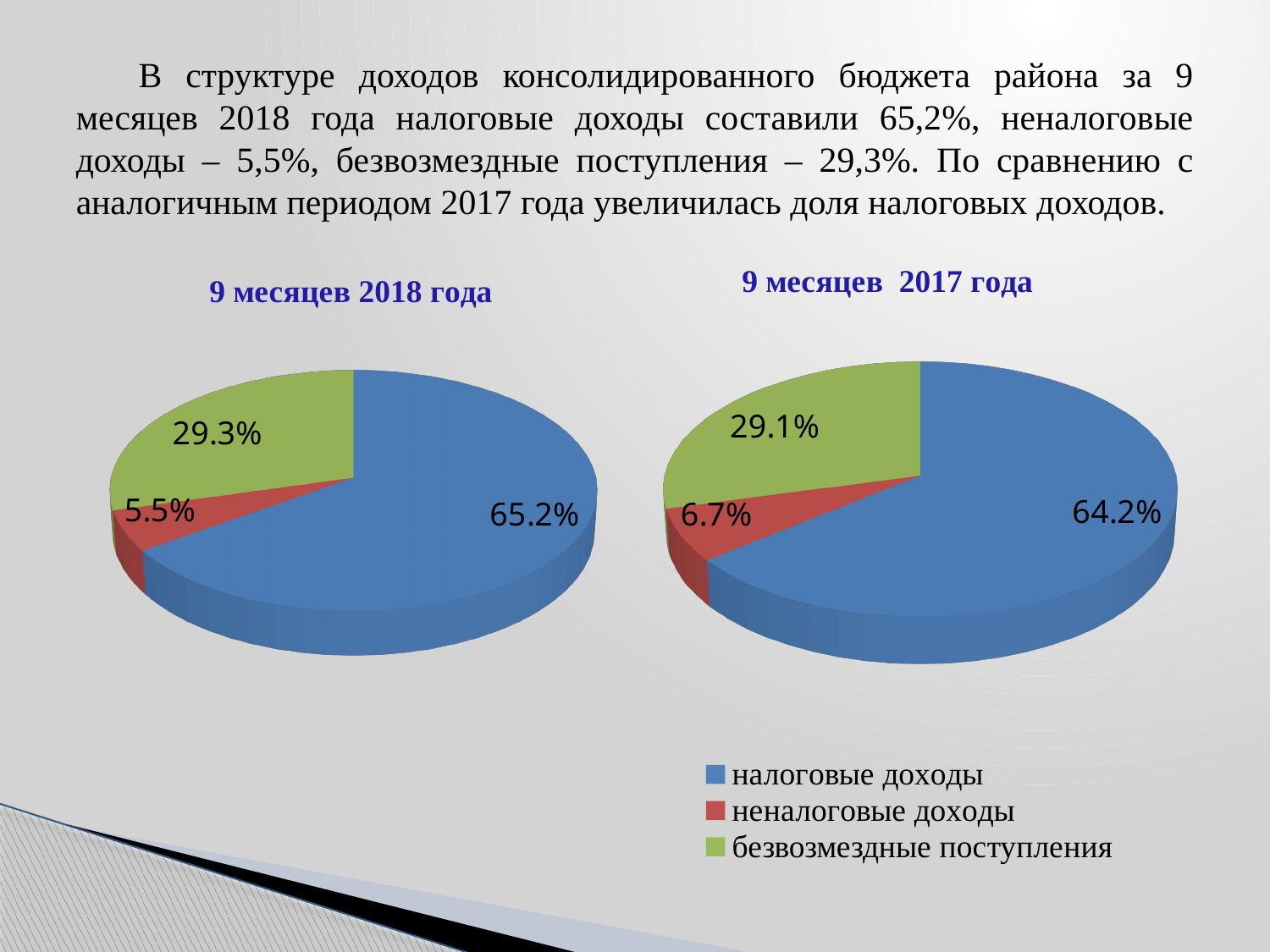
Is the неналоговые доходы share larger in the 2018 chart or in the 2017 chart? 2017 In the '9 месяцев 2018 года' chart, which category has the largest slice? налоговые доходы In the '9 месяцев 2018 года' chart, what share is shown for безвозмездные поступления? 29.3% What type of chart is used on this slide? Pie chart In the '9 месяцев 2017 года' chart, which category has the smallest slice? неналоговые доходы What is the difference between the налоговые доходы share in the 2018 chart and in the 2017 chart? 1.0% In the '9 месяцев 2018 года' chart, what is the difference between the безвозмездные поступления share and the неналоговые доходы share? 23.8% How many slices does the '9 месяцев 2018 года' chart have? 3 In the '9 месяцев 2017 года' chart, what share is shown for неналоговые доходы? 6.7% In the '9 месяцев 2018 года' chart, what share is shown for налоговые доходы? 65.2% Which colour represents безвозмездные поступления in the legend? Green In the '9 месяцев 2017 года' chart, what share is shown for безвозмездные поступления? 29.1%